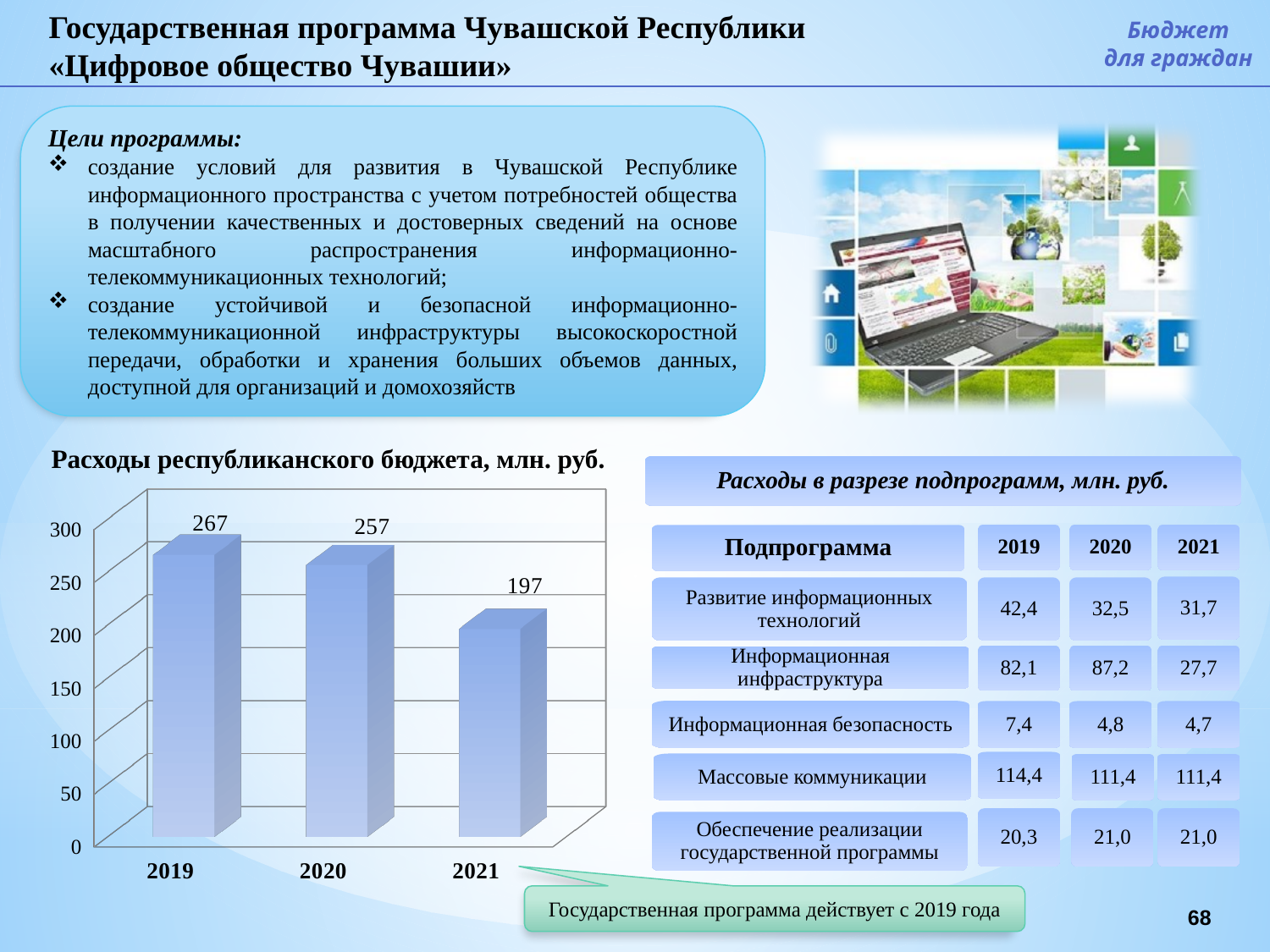
Which year has the highest value in the chart 'Расходы республиканского бюджета, млн. руб.'? 2019 Is the value for 2021 in the chart 'Расходы республиканского бюджета, млн. руб.' greater or less than 200? less What is the value for 2021 in the chart 'Расходы республиканского бюджета, млн. руб.'? 197 What is the value for 2019 in the chart 'Расходы республиканского бюджета, млн. руб.'? 267 What kind of chart is 'Расходы республиканского бюджета, млн. руб.'? bar chart Do the values in the chart 'Расходы республиканского бюджета, млн. руб.' rise or fall from 2019 to 2021? fall What is the value for 2020 in the chart 'Расходы республиканского бюджета, млн. руб.'? 257 Which year has the lowest value in the chart 'Расходы республиканского бюджета, млн. руб.'? 2021 In the chart 'Расходы республиканского бюджета, млн. руб.', which is larger, the value for 2020 or the value for 2021? 2020 How many years are shown in the chart 'Расходы республиканского бюджета, млн. руб.'? 3 What is the difference between the 2019 and 2020 values in the chart 'Расходы республиканского бюджета, млн. руб.'? 10 What is the difference between the 2019 and 2021 values in the chart 'Расходы республиканского бюджета, млн. руб.'? 70